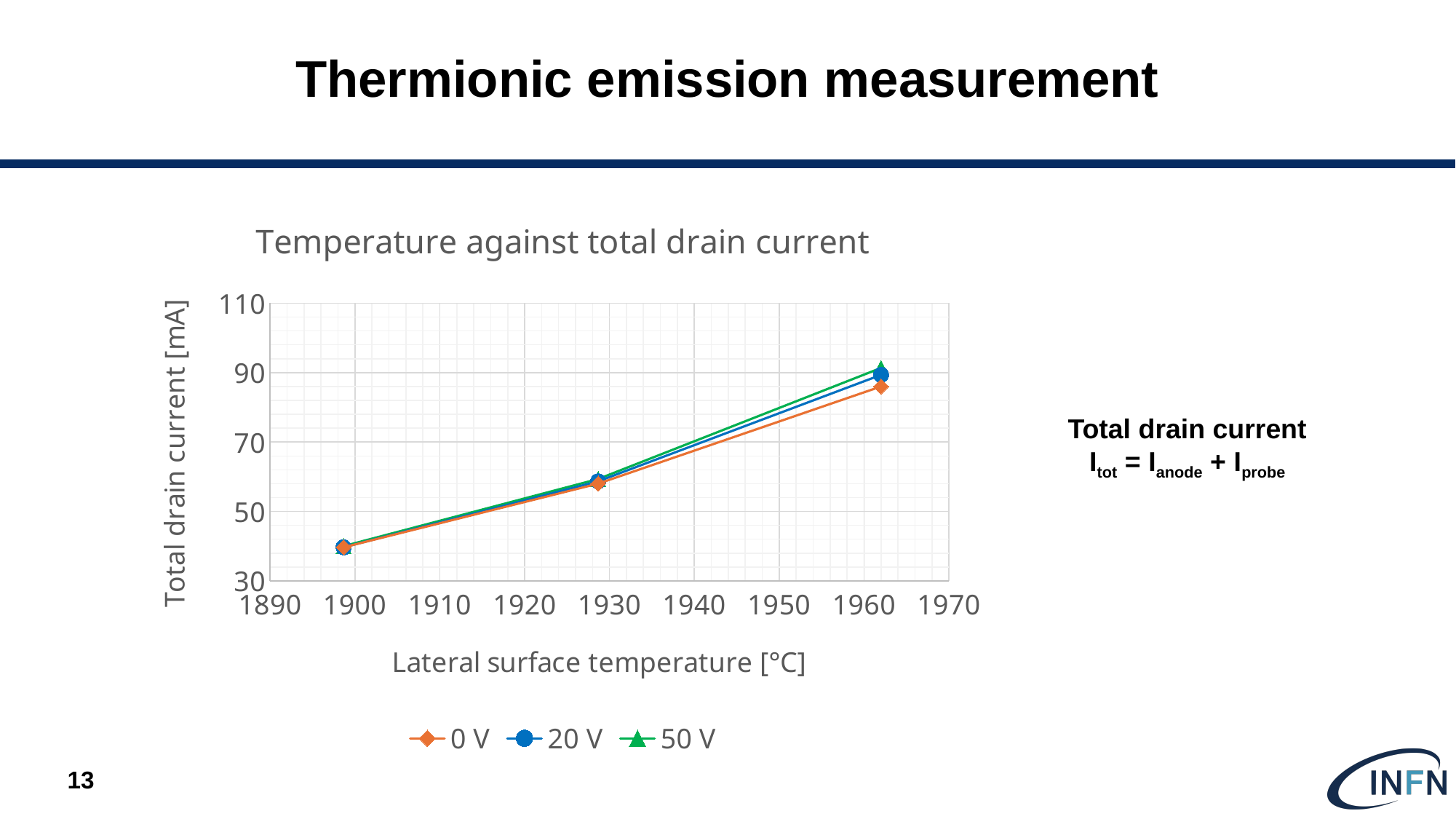
At the highest temperature point, which series has the larger total drain current, 0 V or 50 V? 50 V What kind of chart is shown on the slide? line chart What is the title of the chart? Temperature against total drain current How many series does the legend list? 3 Do the total drain current values rise or fall as the lateral surface temperature increases? rise What is the label of the x axis? Lateral surface temperature [°C] Is the total drain current for the 50 V series at the middle temperature point greater or less than 70? less How many data points are plotted for the 0 V series? 3 Is the total drain current for the 0 V series at the highest temperature greater or less than 70? greater Is the total drain current for the 50 V series at the highest temperature greater or less than 110? less